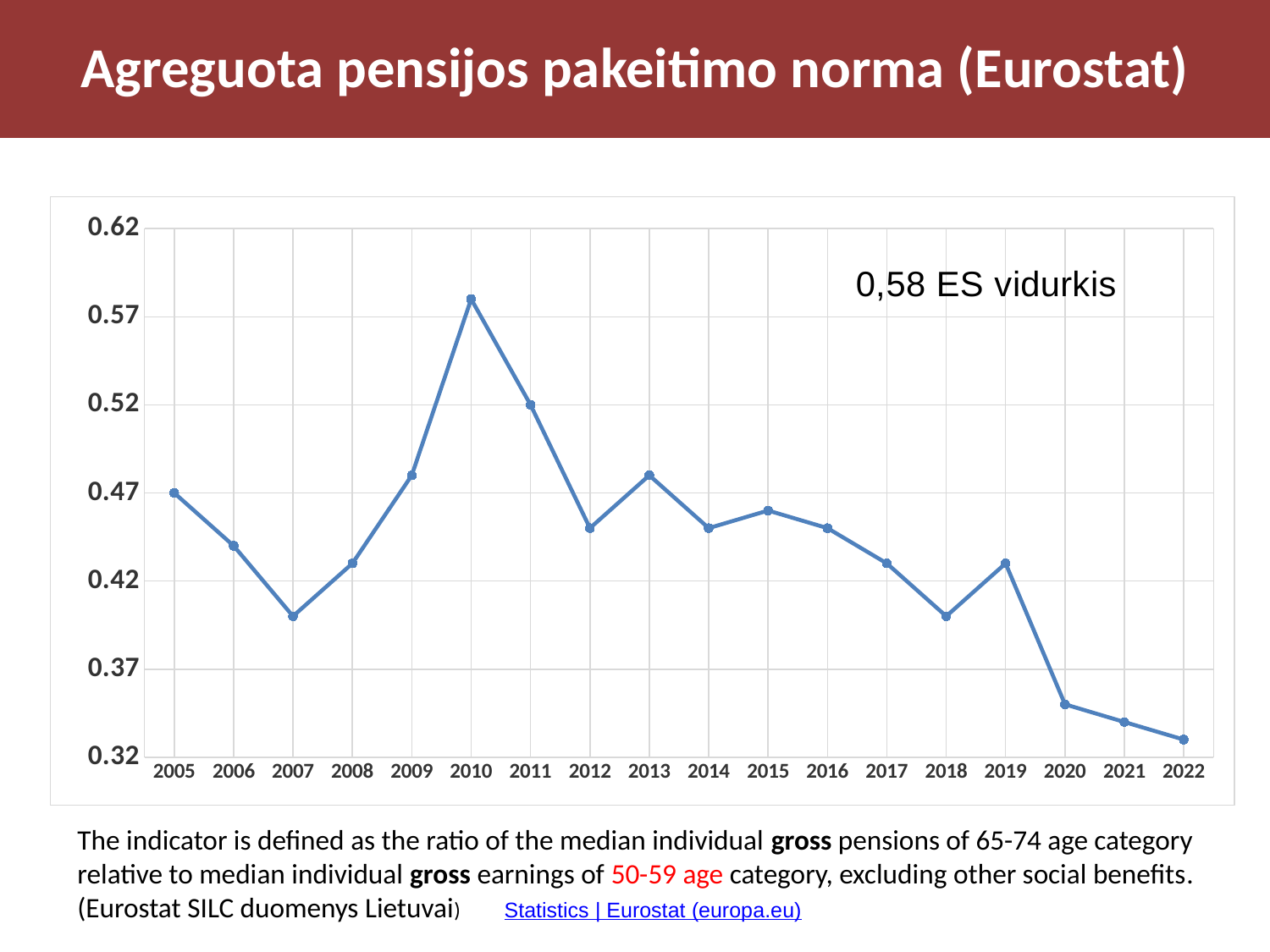
Do the values rise or fall from 2019 to 2022? fall Is the value for 2009 greater or less than 0.47? greater Which year has the lowest value in the chart? 2022 How many years are plotted on the x axis of the chart? 18 Which year has the larger value, 2005 or 2022? 2005 What EU average value is annotated on the chart? 0,58 ES vidurkis Is the value for 2010 greater or less than 0.57? greater Which year has the larger value, 2010 or 2011? 2010 Which year has the highest value in the chart? 2010 Is the value for 2020 greater or less than 0.37? less What kind of chart is shown on the slide? line chart